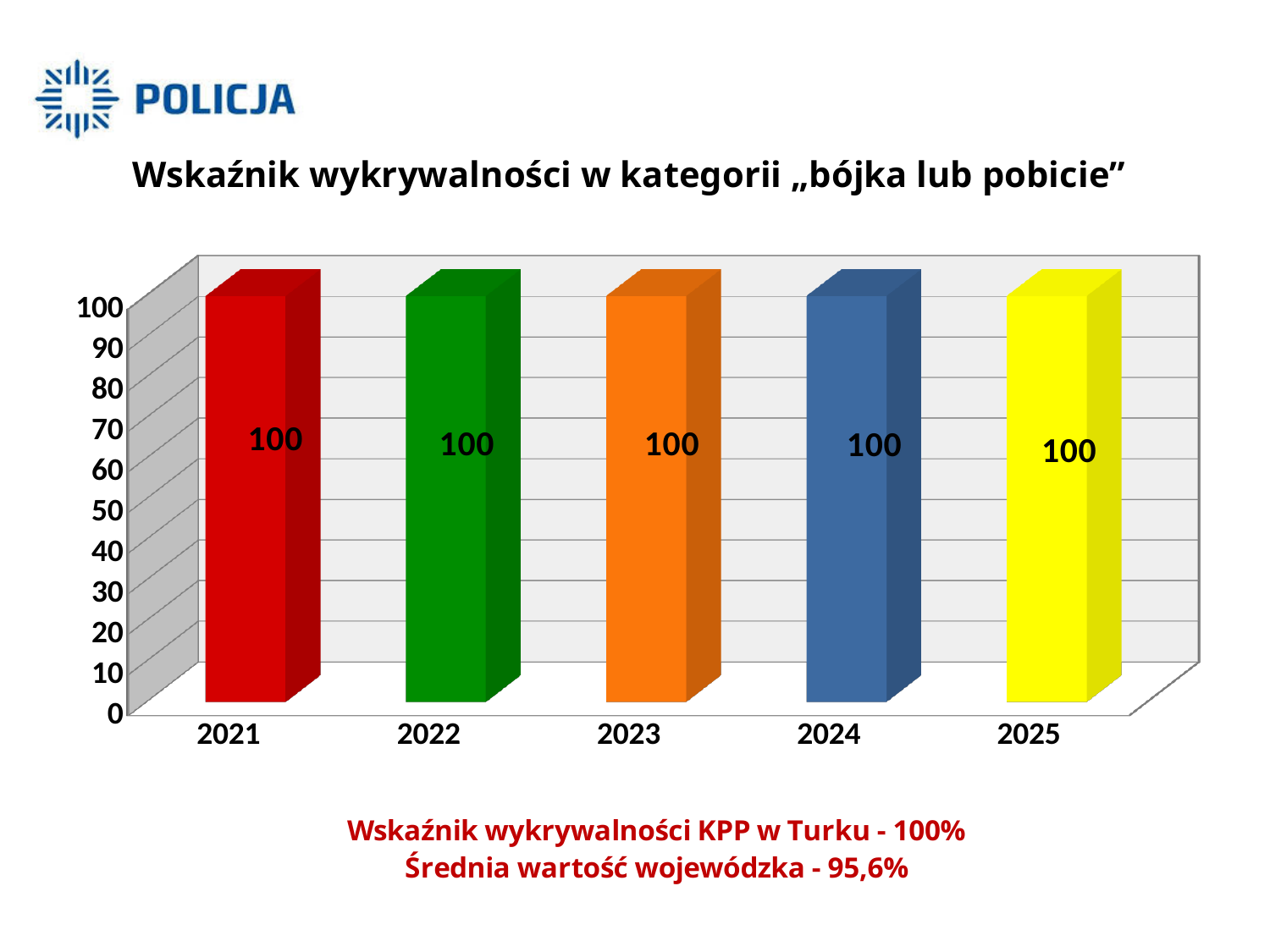
What is the value for 2021? 100 What is the value for 2025? 100 What is the difference between the values for 2022 and 2024? 0 Is the value for 2022 greater or less than 90? greater What kind of chart is shown on the slide? bar chart How many years are shown on the x axis? 5 What is the title of the chart? Wskaźnik wykrywalności w kategorii „bójka lub pobicie” What is the highest tick value shown on the vertical axis? 100 What colour is the bar for 2024? blue What is the value for 2023? 100 Do the values rise, fall or stay the same from 2021 to 2025? stay the same